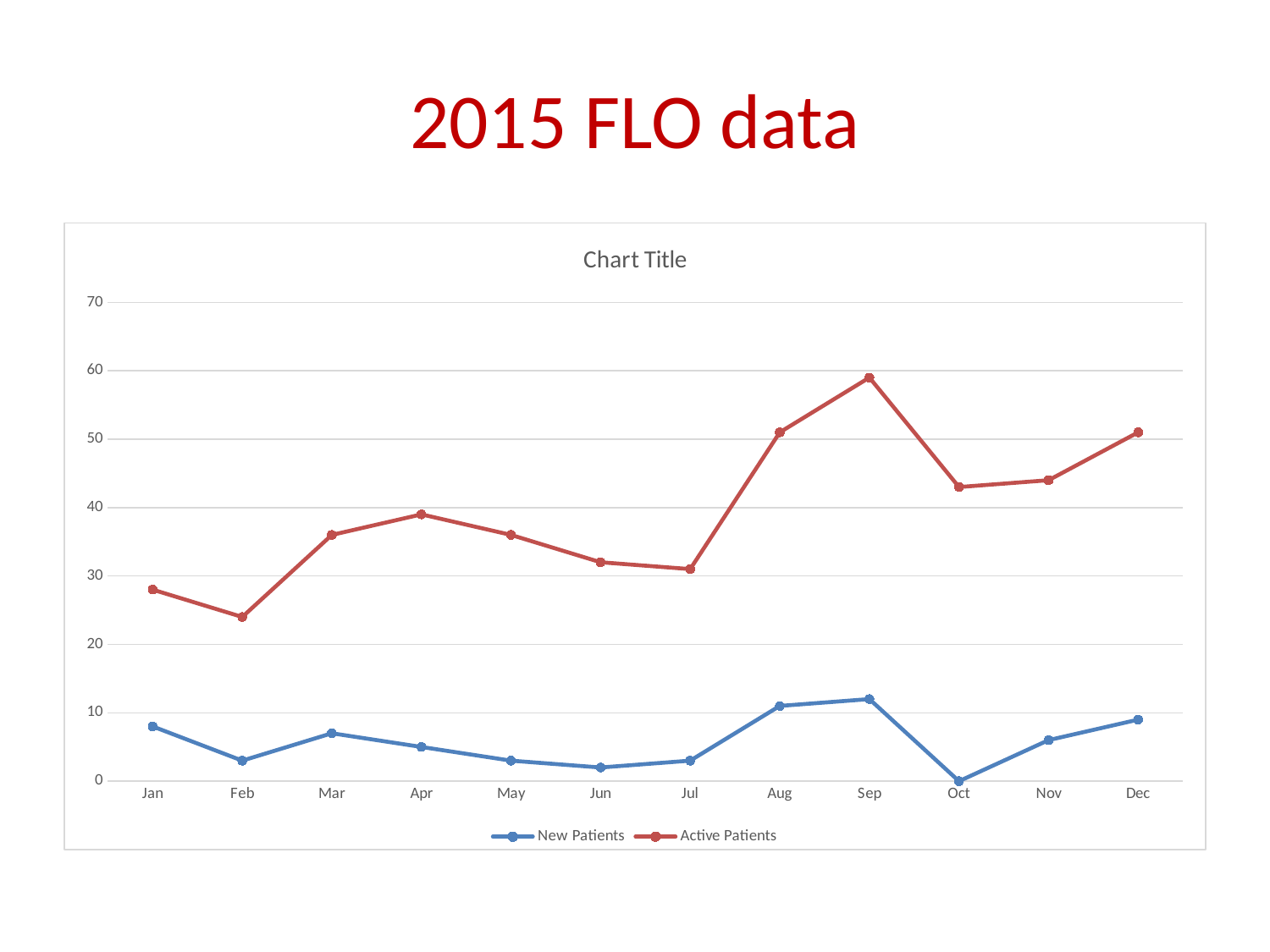
In which month is the Active Patients value lowest? Feb How many months are plotted along the x axis? 12 Is the value for New Patients in Jun greater or less than 10? less What type of chart is shown on the slide? line chart In which month is the New Patients value lowest? Oct What is the value for New Patients in Oct? 0 Is the value for Active Patients in Feb greater or less than 30? less In which month is the Active Patients value highest? Sep Does the Active Patients line rise or fall from Jul to Sep? rise Is the value for Active Patients in Sep greater or less than 50? greater Which is larger for Active Patients: the value in Sep or the value in Oct? Sep How many series does the legend list? 2